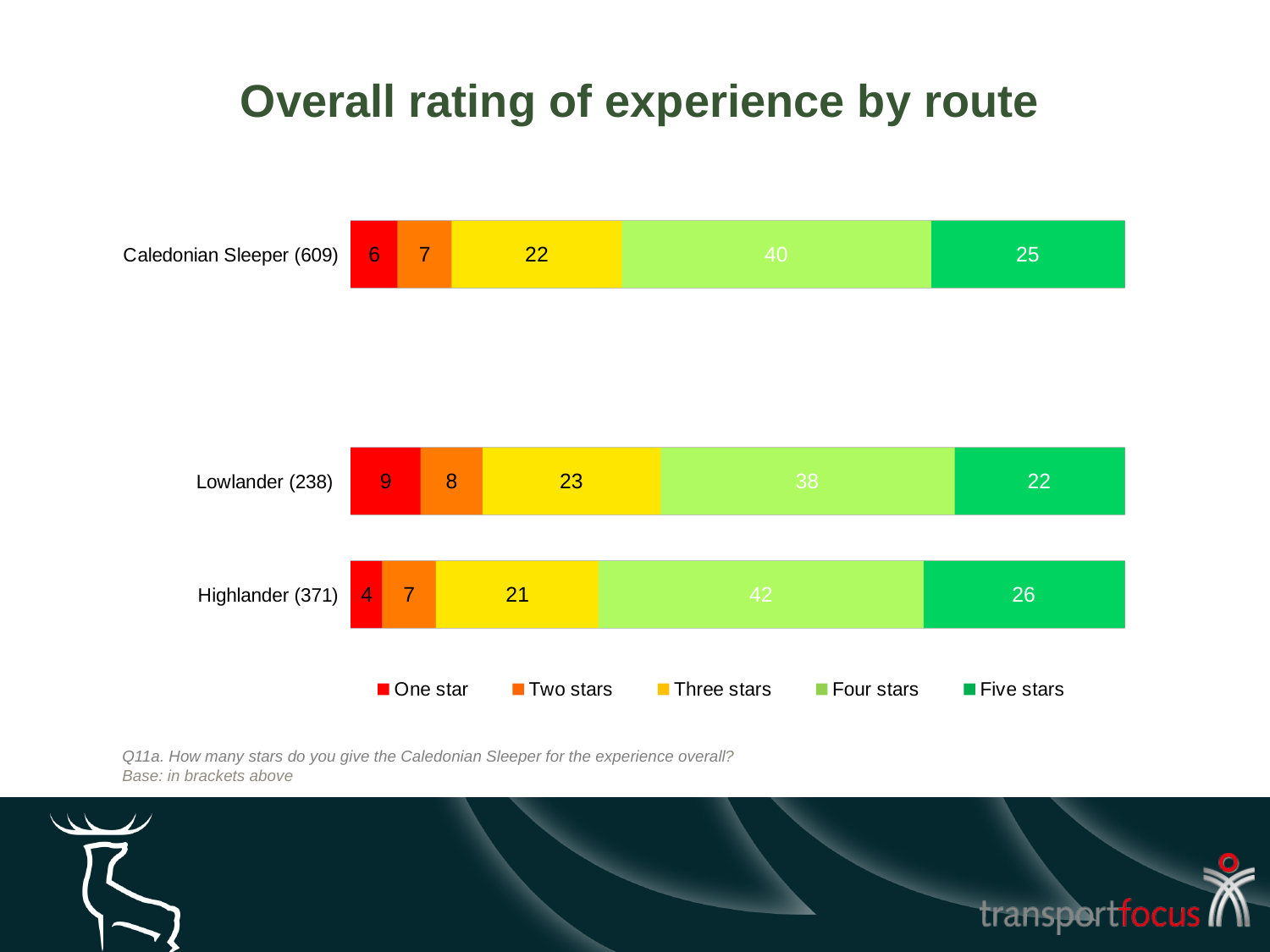
What is the Five stars value for Highlander (371)? 26 Which is larger, the Two stars value for Lowlander (238) or for Highlander (371)? Lowlander (238) What kind of chart is shown on the slide? Stacked bar chart How many series does the legend list? 5 What is the total of the stacked bar for Caledonian Sleeper (609)? 100 What is the Three stars value for Lowlander (238)? 23 What is the Four stars value for Caledonian Sleeper (609)? 40 What is the One star value for Lowlander (238)? 9 What is the difference between the Five stars values for Highlander (371) and Lowlander (238)? 4 Which route has the highest Four stars value? Highlander (371) Which route has the lowest One star value? Highlander (371) How many routes are shown in the chart? 3